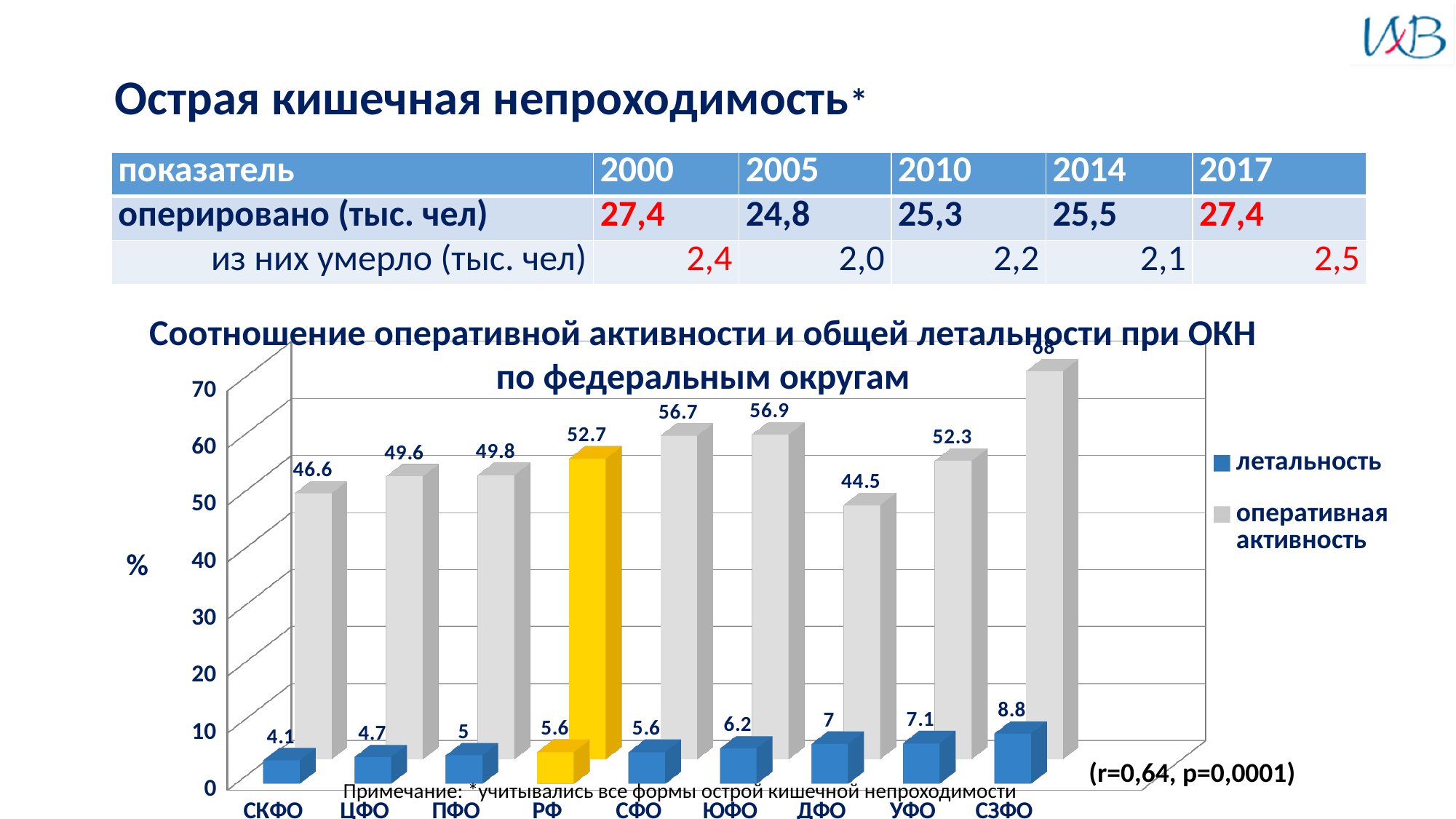
Which category has the lowest оперативная активность? ДФО What is the value of оперативная активность for ДФО? 44.5 Which category has the highest летальность? СЗФО What is the value of оперативная активность for СЗФО? 68 Does летальность rise or fall moving from СКФО to СЗФО along the x axis? rise What kind of chart is shown on the slide? bar chart How many federal districts (categories) are shown on the x axis of the chart? 9 What is the value of летальность for РФ? 5.6 Which is larger: летальность for ЮФО or летальность for ЦФО? ЮФО How many series does the chart legend list? 2 What is the difference between оперативная активность for СЗФО and for СКФО? 21.4 Which category's bars are highlighted in yellow on the chart? РФ